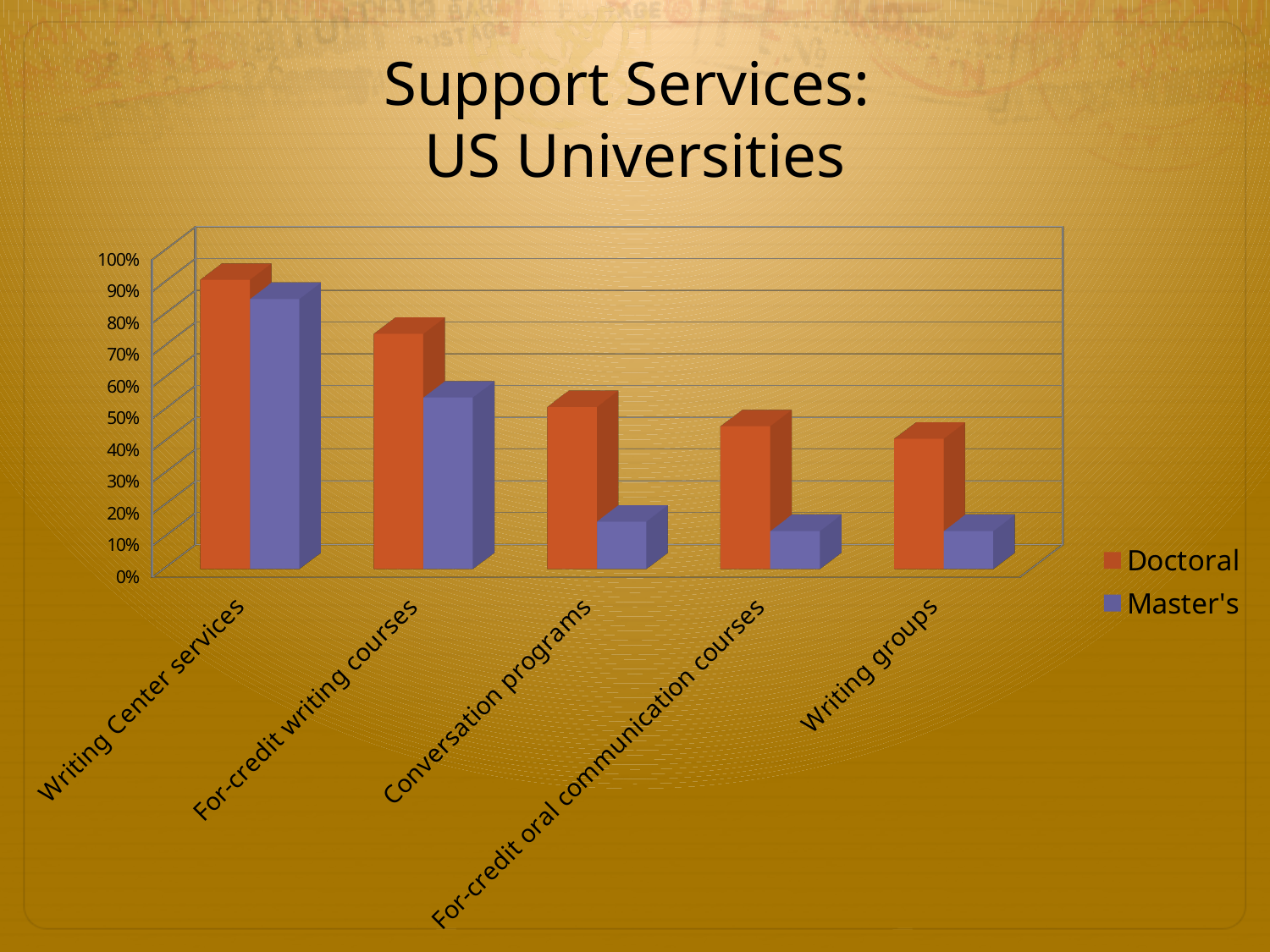
What are the two series named in the legend? Doctoral and Master's How many series does the legend list? 2 For Conversation programs, which is larger, the Doctoral value or the Master's value? Doctoral Which category has the highest Master's value? Writing Center services Is the Doctoral value for Writing groups greater or less than 60%? less How many categories are shown on the x axis of the chart? 5 Is the Doctoral value for Writing Center services greater or less than 80%? greater What kind of chart is shown on the slide? bar chart Which category has the highest Doctoral value? Writing Center services Is the Master's value for For-credit writing courses greater or less than 40%? greater Do the Doctoral values rise or fall moving from left to right across the categories? fall